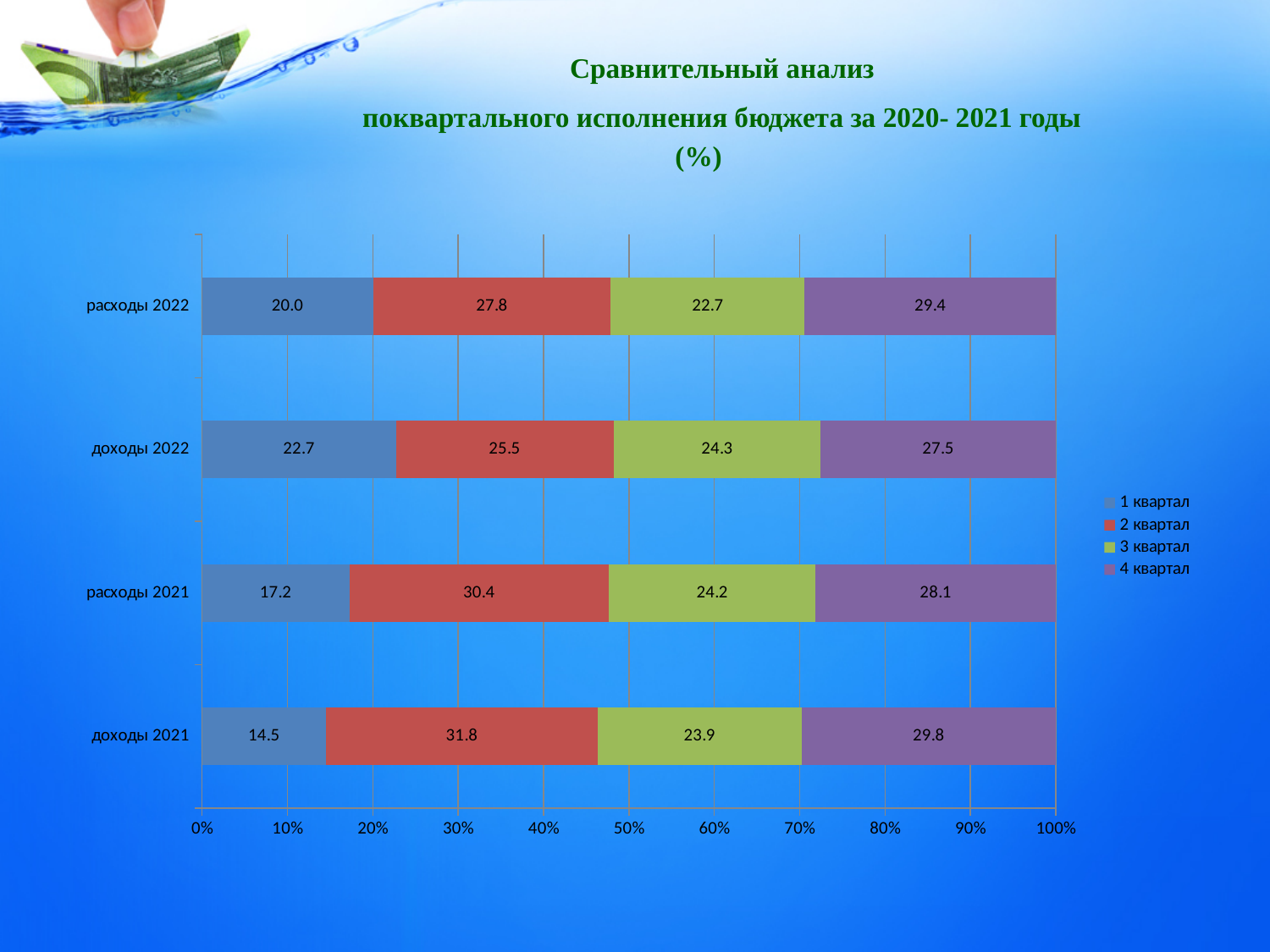
What is the value for 1 квартал in the доходы 2021 bar? 14.5 Which category has the lowest value for 1 квартал? доходы 2021 What is the value for 4 квартал in the расходы 2022 bar? 29.4 What is the value for 2 квартал in the расходы 2021 bar? 30.4 How many series does the legend list? 4 What is the value for 3 квартал in the доходы 2022 bar? 24.3 Which is larger: the 4 квартал value for расходы 2021 or for доходы 2021? доходы 2021 What is the total of the доходы 2022 stacked bar? 100.0 What is the difference between the 2 квартал values for доходы 2021 and доходы 2022? 6.3 How many categories are shown on the vertical axis? 4 Which category has the highest value for 2 квартал? доходы 2021 What kind of chart is shown on the slide? Stacked bar chart